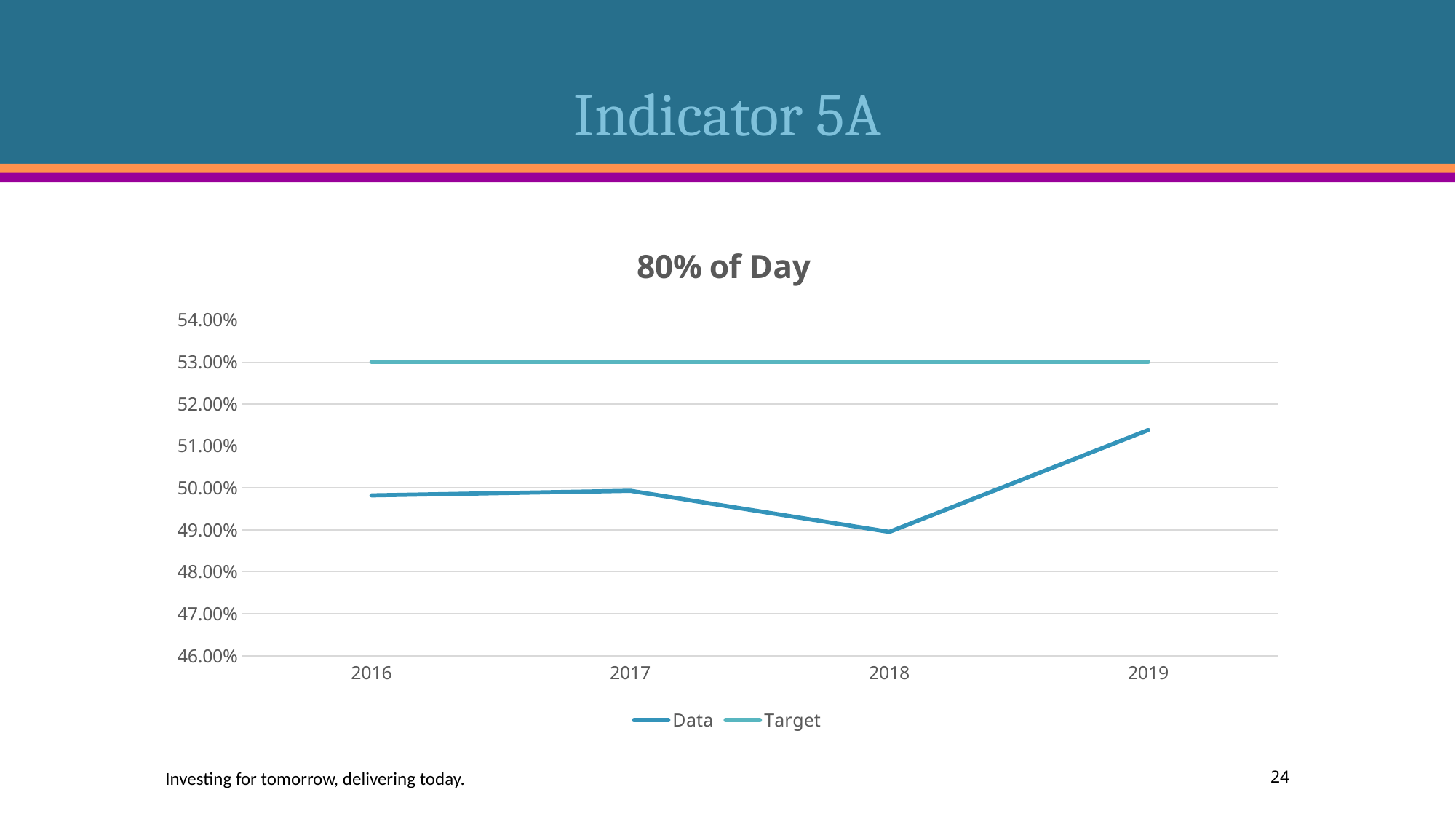
Which is larger, the Data value for 2019 or the Data value for 2018? 2019 What are the names of the two series in the legend? Data and Target What is the title of the chart? 80% of Day Does the Data series rise or fall from 2018 to 2019? Rise How many series does the legend list? 2 How many years are shown on the x axis? 4 In which year is the Data series highest? 2019 Is the Data value for 2018 greater or less than 50.00%? less Is the Data value for 2019 greater or less than 51.00%? greater In which year is the Data series lowest? 2018 What is the value of the Target series across the years? 53.00% What kind of chart is shown on the slide? Line chart